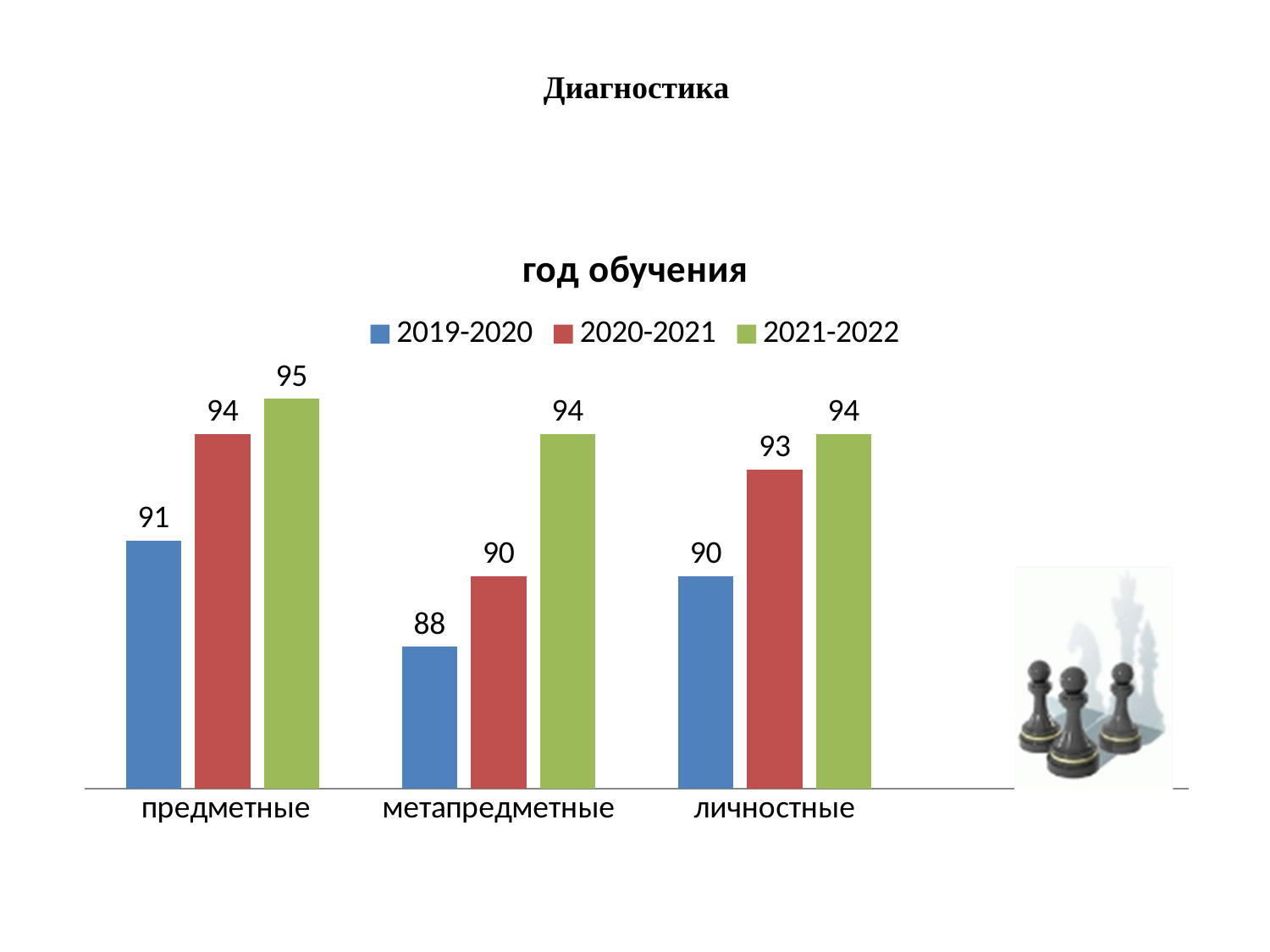
How many series does the legend list? 3 What is the value for метапредметные in the 2021-2022 series? 94 What is the value for предметные in the 2019-2020 series? 91 What is the difference between the 2020-2021 values for предметные and личностные? 1 Which category has the lowest value in the 2019-2020 series? метапредметные What is the difference between the 2021-2022 and 2019-2020 values for метапредметные? 6 What is the title of the chart? год обучения What is the value for личностные in the 2020-2021 series? 93 What kind of chart is shown on the slide? bar chart How many categories are shown on the x axis? 3 Which category has the highest value in the 2021-2022 series? предметные Which is larger: the 2019-2020 value for предметные or the 2019-2020 value for личностные? предметные